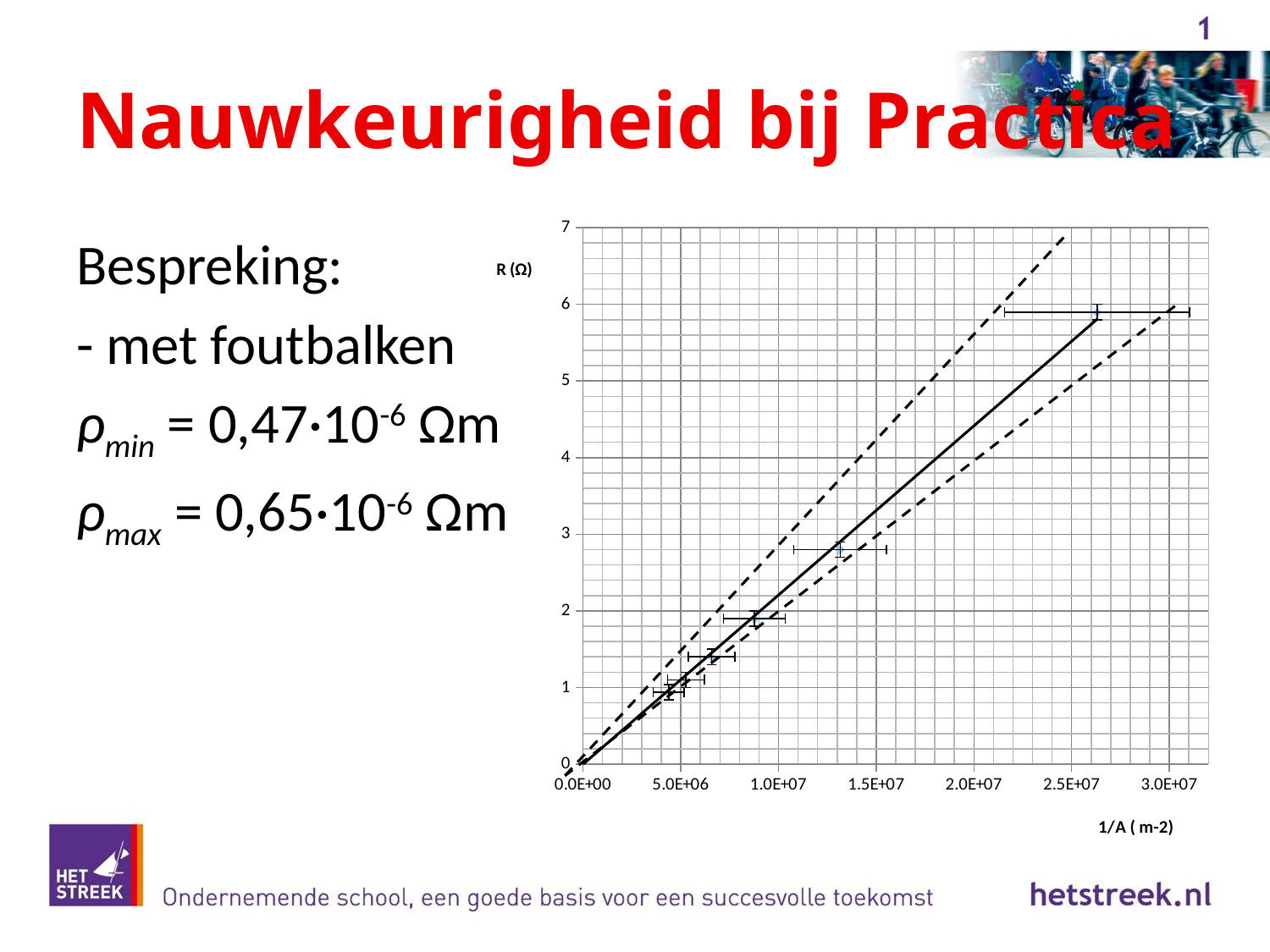
Which data point has the highest R value: the one near 1/A = 1.5E+07 or the one near 1/A = 2.5E+07? the one near 1/A = 2.5E+07 What is the highest tick value shown on the vertical axis of the chart? 7 Is the R value of the data point near 1/A = 1.5E+07 greater or less than 2? greater Is the R value of the rightmost data point (near 1/A = 2.5E+07) greater or less than 5? greater What is the label of the vertical axis of the chart? R (Ω) What is the label of the horizontal axis of the chart? 1/A ( m-2) What is the highest tick value shown on the horizontal axis of the chart? 3.0E+07 How many data points with error bars are plotted on the chart? 6 What kind of chart is shown on the slide? scatter chart with error bars and fitted lines Is the R value of the leftmost data point (near 1/A = 5.0E+06) greater or less than 2? less Do the plotted values of R rise or fall as 1/A increases along the x axis? rise